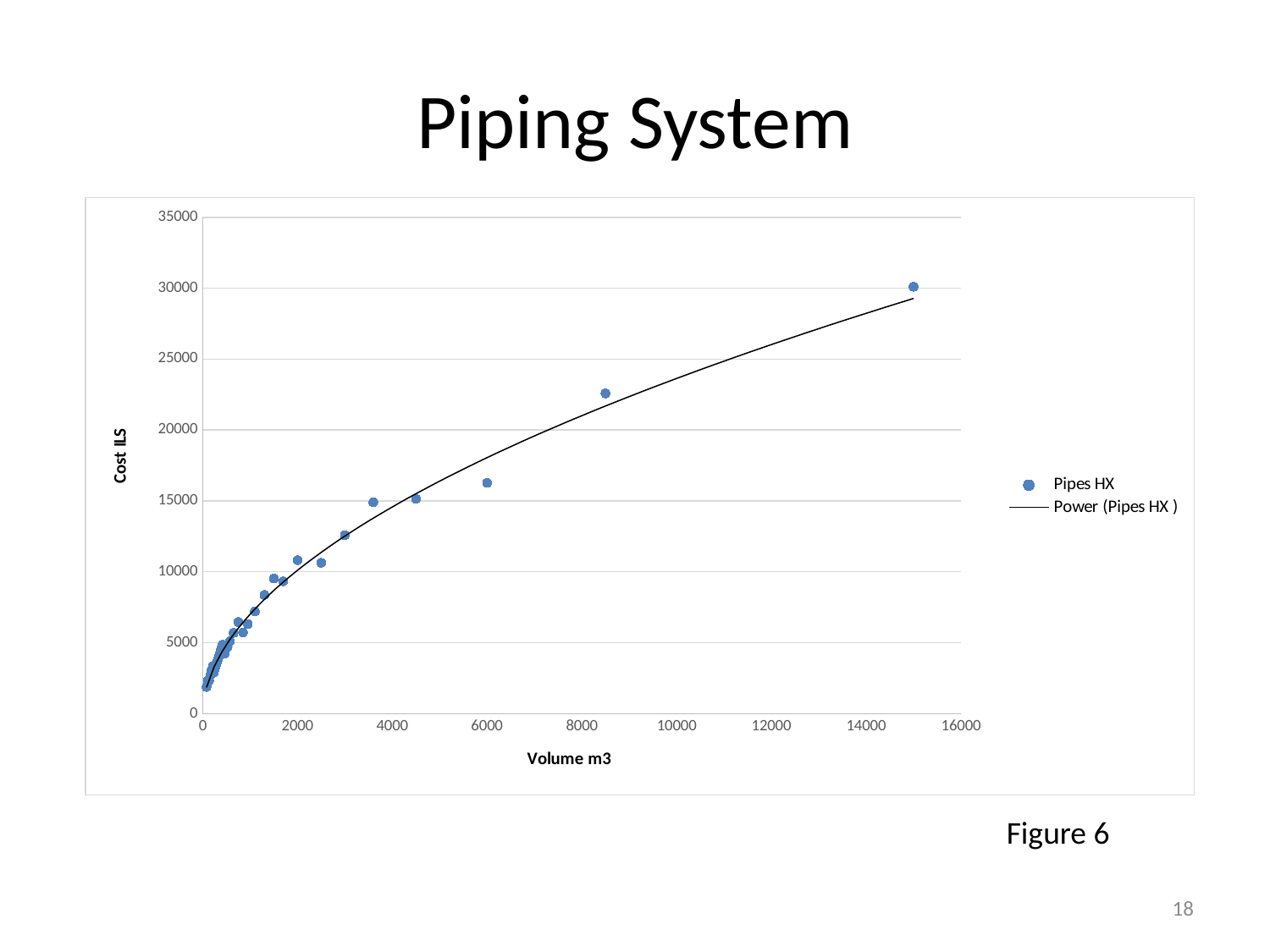
What is the label of the x axis? Volume m3 What kind of chart is shown on the slide? scatter chart How many entries does the chart legend list? 2 Which data point has the highest cost: the one near 15000 m3 or the one near 8500 m3? the one near 15000 m3 Is the cost of the data point near 8500 m3 greater or less than 20000? greater Is the cost of the rightmost data point (near 15000 m3) greater or less than 25000? greater Is the cost of the data point near 8500 m3 greater or less than 25000? less Does the cost rise or fall as volume increases along the x axis? rises What are the two entries in the chart legend? Pipes HX and Power (Pipes HX )